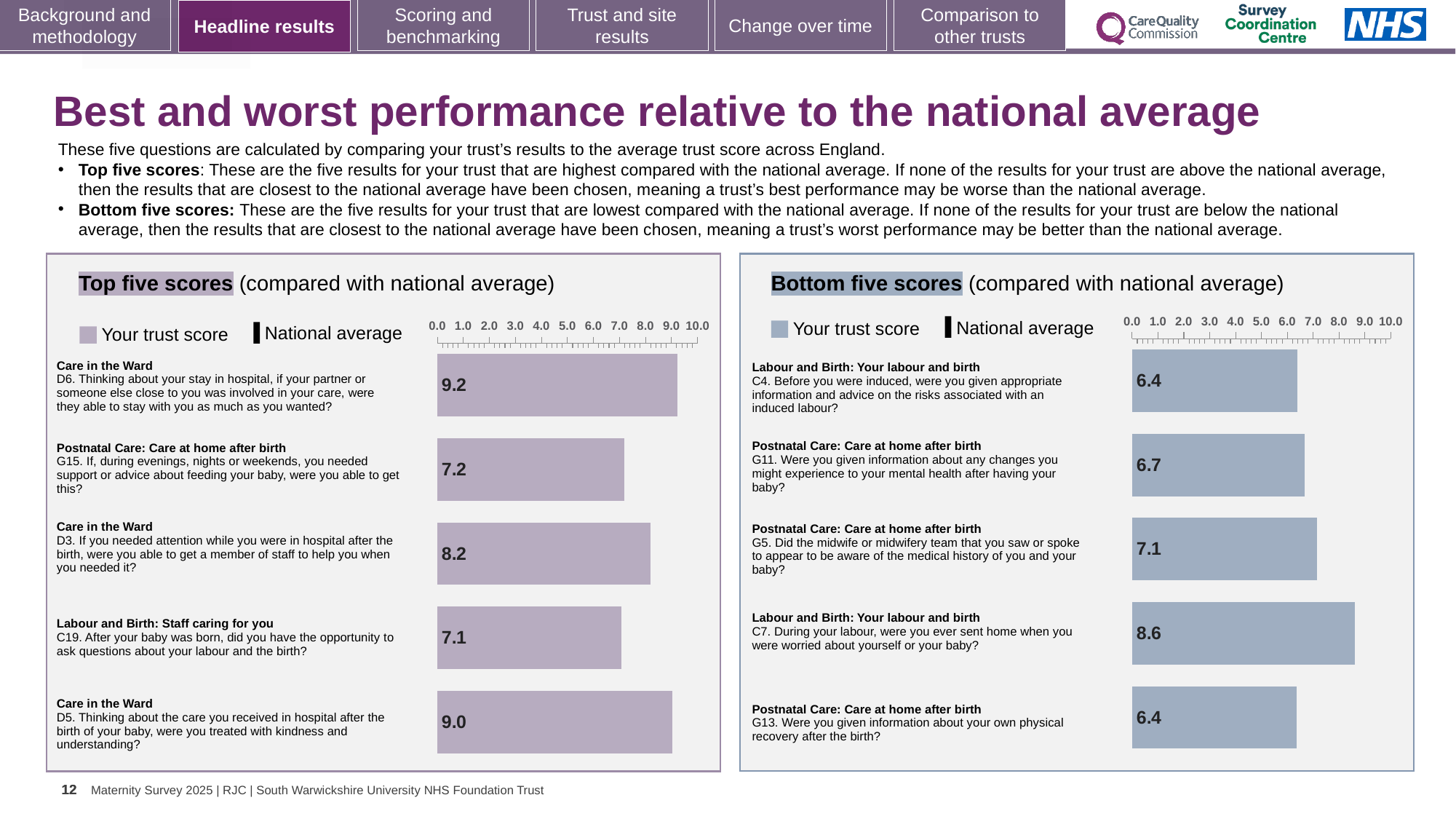
In the Top five scores chart, what is the trust score for question D6 about your partner being able to stay with you as much as you wanted? 9.2 In the Top five scores chart, is the trust score for D3 greater or less than 8.0? greater In the Bottom five scores chart, what is the trust score for question G13 about information on your own physical recovery after the birth? 6.4 In the Bottom five scores chart, which question has the highest trust score? C7 (Labour and Birth: Your labour and birth) In the Bottom five scores chart, what is the difference between the trust scores for C7 and C4? 2.2 In the Top five scores chart, what is the difference between the trust scores for D6 and C19? 2.1 In the Bottom five scores chart, which has the larger trust score, G11 or G5? G5 In the Top five scores chart, which question has the lowest trust score? C19 (Labour and Birth: Staff caring for you) How many bars are shown in the Top five scores chart? 5 In the Bottom five scores chart, what is the trust score for question C7 about being sent home during labour when worried? 8.6 What type of chart is used in the Bottom five scores panel? Bar chart In the Top five scores chart, which question has the highest trust score? D6 (Care in the Ward)